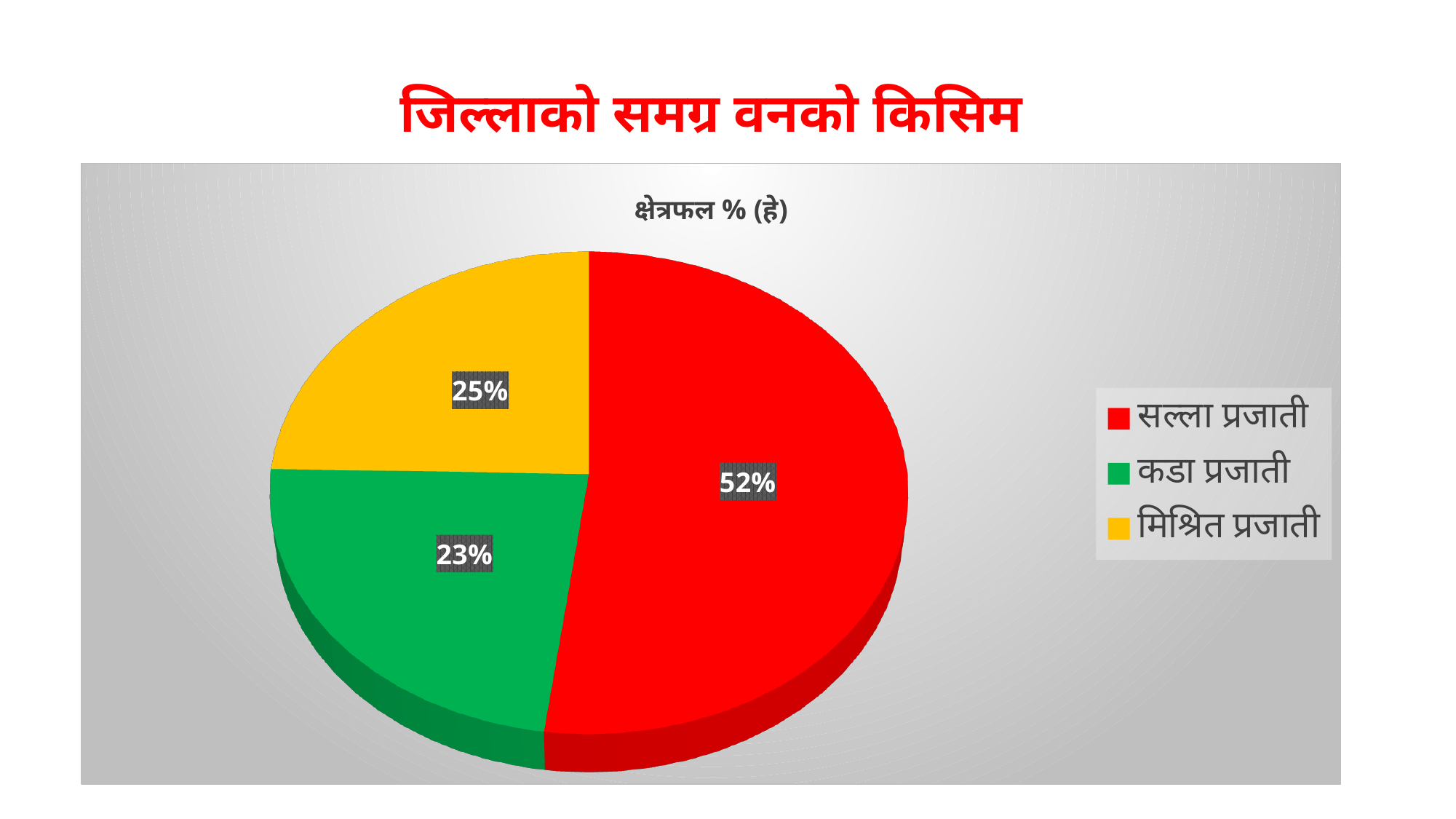
How many categories does the pie chart have? 3 What is the value shown for सल्ला प्रजाती? 52% What is the value shown for कडा प्रजाती? 23% Which category has the largest share of the pie? सल्ला प्रजाती Which colour represents कडा प्रजाती in the chart? Green What kind of chart is shown on the slide? Pie chart Which is larger, the share of कडा प्रजाती or the share of मिश्रित प्रजाती? मिश्रित प्रजाती What is the difference between the shares of सल्ला प्रजाती and मिश्रित प्रजाती? 27% What is the value shown for मिश्रित प्रजाती? 25% Which category has the smallest share of the pie? कडा प्रजाती What is the title of the chart? क्षेत्रफल % (हे) What is the difference between the shares of मिश्रित प्रजाती and कडा प्रजाती? 2%